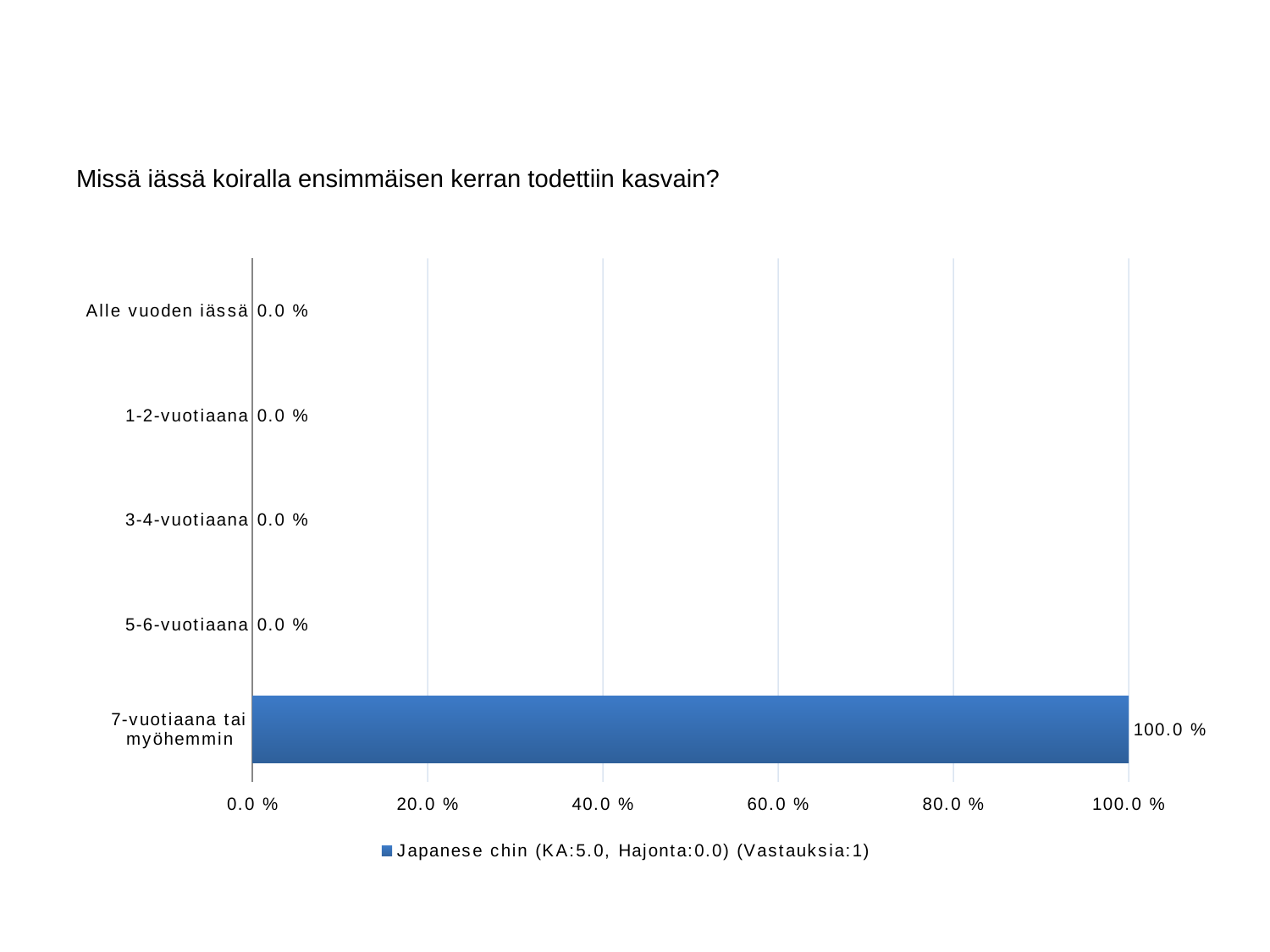
What is the difference between the values for "7-vuotiaana tai myöhemmin" and "5-6-vuotiaana"? 100.0 % How many categories are shown on the chart? 5 What is the title of the chart? Missä iässä koiralla ensimmäisen kerran todettiin kasvain? Is the value for "7-vuotiaana tai myöhemmin" greater or less than 80.0 %? greater What is the legend entry for the series? Japanese chin (KA:5.0, Hajonta:0.0) (Vastauksia:1) What kind of chart is shown on the slide? bar chart Which is larger, the value for "7-vuotiaana tai myöhemmin" or the value for "1-2-vuotiaana"? 7-vuotiaana tai myöhemmin What is the value for "3-4-vuotiaana"? 0.0 % What is the value for "Alle vuoden iässä"? 0.0 % What is the value for "7-vuotiaana tai myöhemmin"? 100.0 % How many series does the legend list? 1 Which category has the highest value? 7-vuotiaana tai myöhemmin